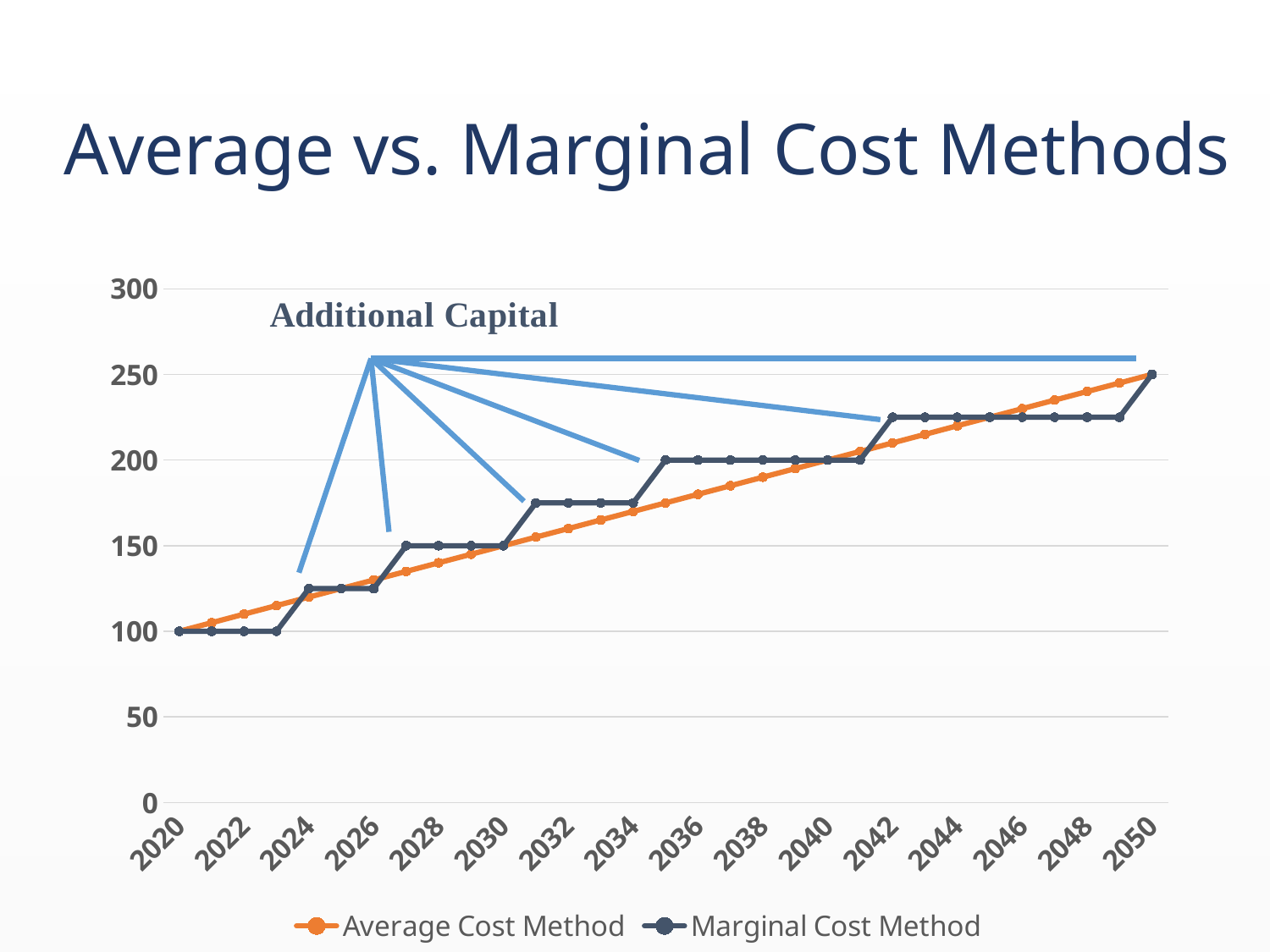
Is the value of the Average Cost Method in 2036 greater or less than 200? less In 2032, which series has the higher value, Average Cost Method or Marginal Cost Method? Marginal Cost Method What is the value of the Average Cost Method in 2050? 250 What is the value of the Marginal Cost Method in 2020? 100 Is the value of the Marginal Cost Method in 2024 greater or less than 100? greater How many series does the legend list? 2 In 2048, which series has the higher value, Average Cost Method or Marginal Cost Method? Average Cost Method Is the value of the Marginal Cost Method in 2044 greater or less than 200? greater What is the value of the Marginal Cost Method in 2036? 200 Do the values of the Average Cost Method rise or fall from 2020 to 2050? Rise What kind of chart is shown on the slide? Line chart What annotation text is written above the blue lines pointing to the steps in the Marginal Cost Method line? Additional Capital